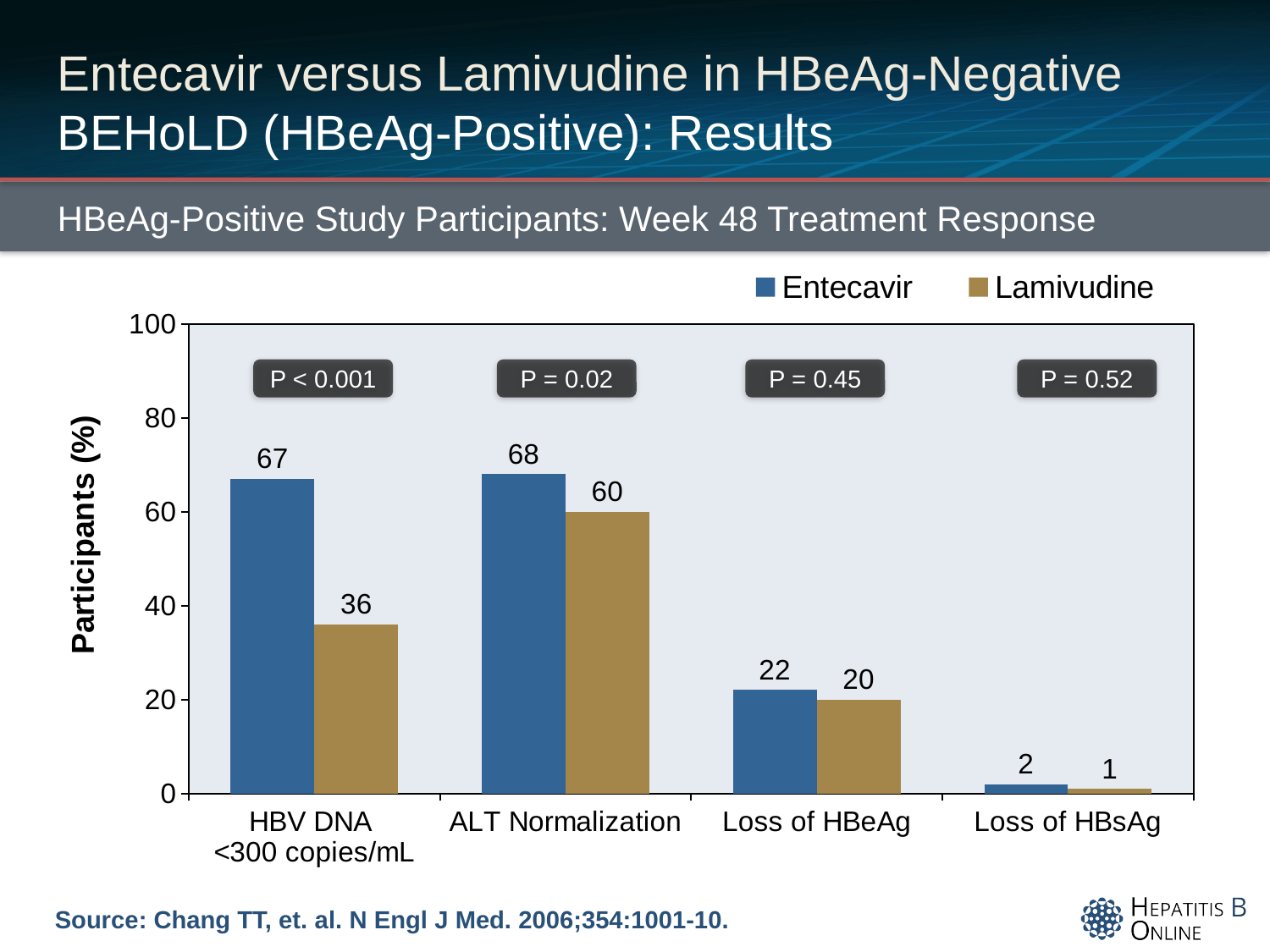
Which is larger for ALT Normalization, the Entecavir value or the Lamivudine value? Entecavir What is the difference between the Entecavir and Lamivudine values for HBV DNA <300 copies/mL? 31 How many categories are shown on the x axis? 4 Which category has the highest Entecavir value? ALT Normalization How many series does the legend list? 2 What is the Lamivudine value for ALT Normalization? 60 What is the Lamivudine value for Loss of HBeAg? 20 What P value is shown above the Loss of HBeAg bars? P = 0.45 What percentage of Entecavir participants achieved HBV DNA <300 copies/mL? 67 Which category has the lowest Lamivudine value? Loss of HBsAg Is the Lamivudine value for HBV DNA <300 copies/mL greater or less than 40? less What kind of chart is shown on the slide? bar chart